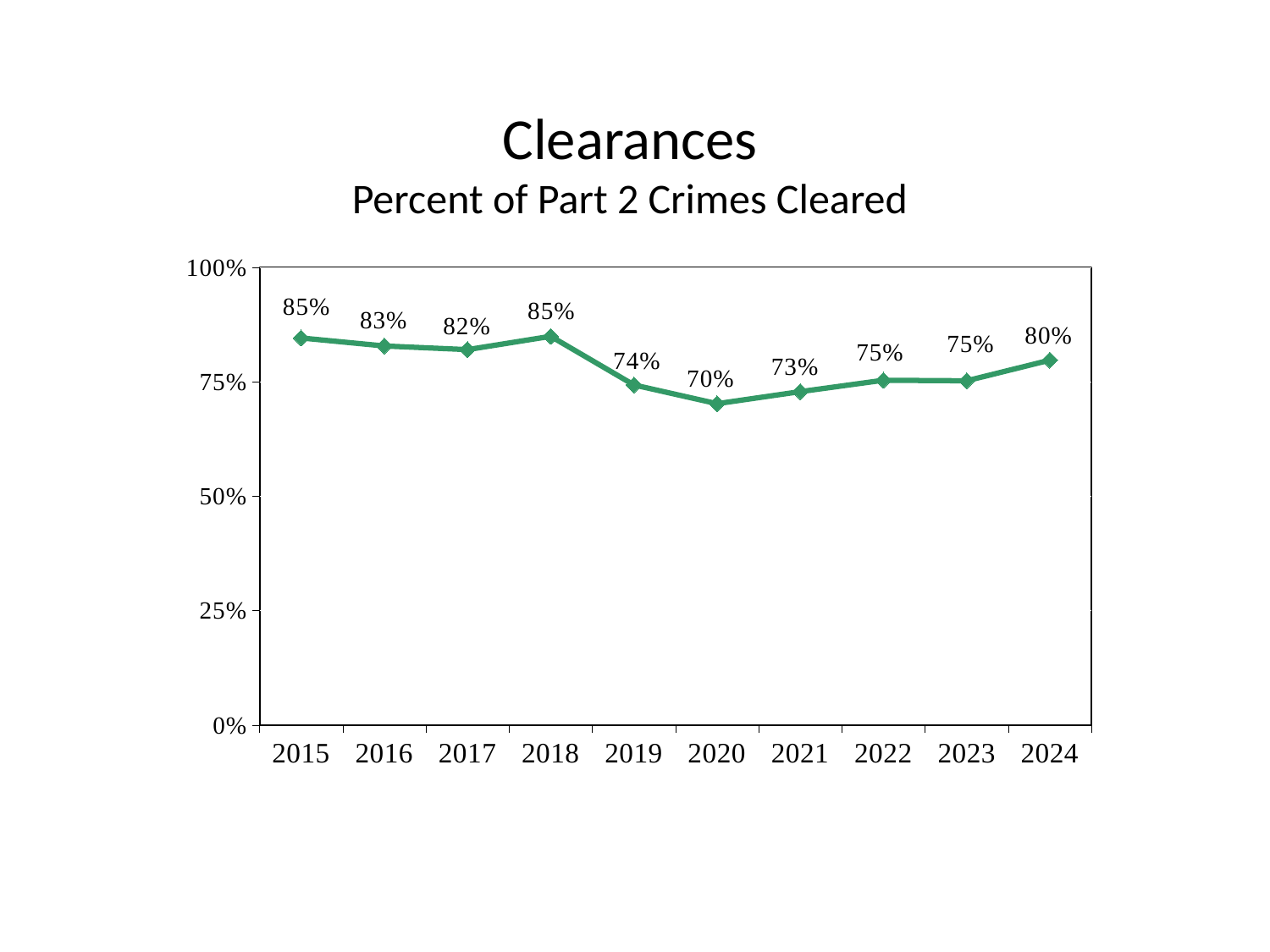
What percent of Part 2 crimes were cleared in 2020? 70% What is the difference between the 2024 value and the 2020 value? 10% How many years are plotted on the chart? 10 Which is larger, the value for 2016 or the value for 2021? 2016 What kind of chart is shown on the slide? Line chart Which year has the lowest percent of Part 2 crimes cleared? 2020 What is the value shown for 2024? 80% What is the subtitle of the chart? Percent of Part 2 Crimes Cleared What is the value shown for 2017? 82% Does the value rise or fall from 2018 to 2020? Fall Is the value for 2019 greater or less than 50%? greater What is the difference between the 2018 value and the 2019 value? 11%